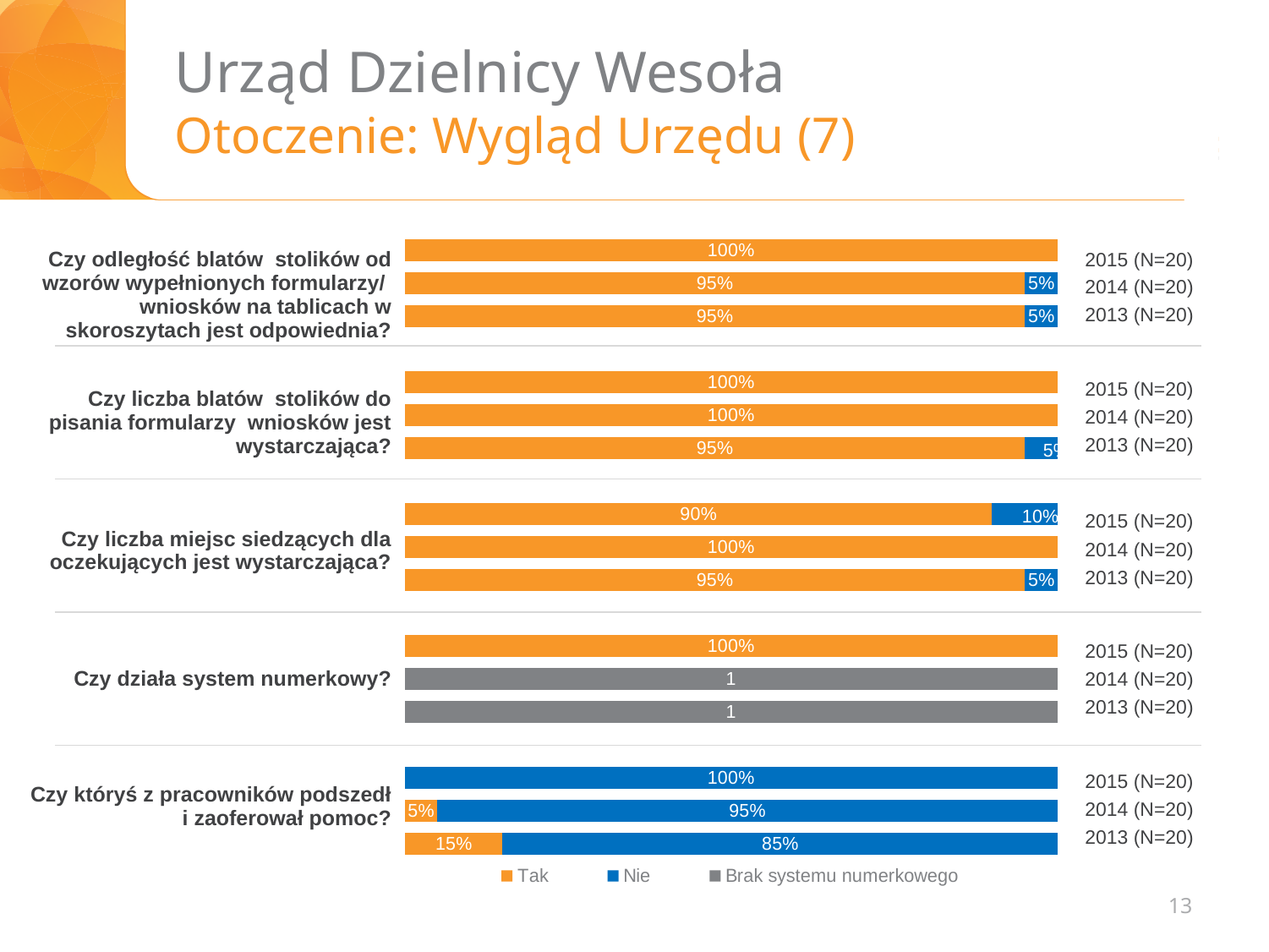
What percentage of respondents answered "Tak" in 2015 to "Czy liczba miejsc siedzących dla oczekujących jest wystarczająca?"? 90% Which legend entry is shown in grey? Brak systemu numerkowego What percentage answered "Tak" in 2014 to "Czy odległość blatów stolików od wzorów wypełnionych formularzy/wniosków na tablicach w skoroszytach jest odpowiednia?"? 95% What percentage answered "Tak" in 2013 to "Czy któryś z pracowników podszedł i zaoferował pomoc?"? 15% For "Czy któryś z pracowników podszedł i zaoferował pomoc?", what is the difference between the "Nie" share in 2015 and in 2013? 15% For "Czy któryś z pracowników podszedł i zaoferował pomoc?", does the "Tak" share rise or fall from 2013 to 2015? Fall What kind of chart is shown on the slide? Stacked bar chart For "Czy liczba miejsc siedzących dla oczekujących jest wystarczająca?", which year has the lowest "Tak" share? 2015 How many survey questions (bar groups) are shown in the chart? 5 What percentage answered "Nie" in 2014 to "Czy któryś z pracowników podszedł i zaoferował pomoc?"? 95% What percentage answered "Nie" in 2015 to "Czy liczba miejsc siedzących dla oczekujących jest wystarczająca?"? 10% How many series does the legend list? 3